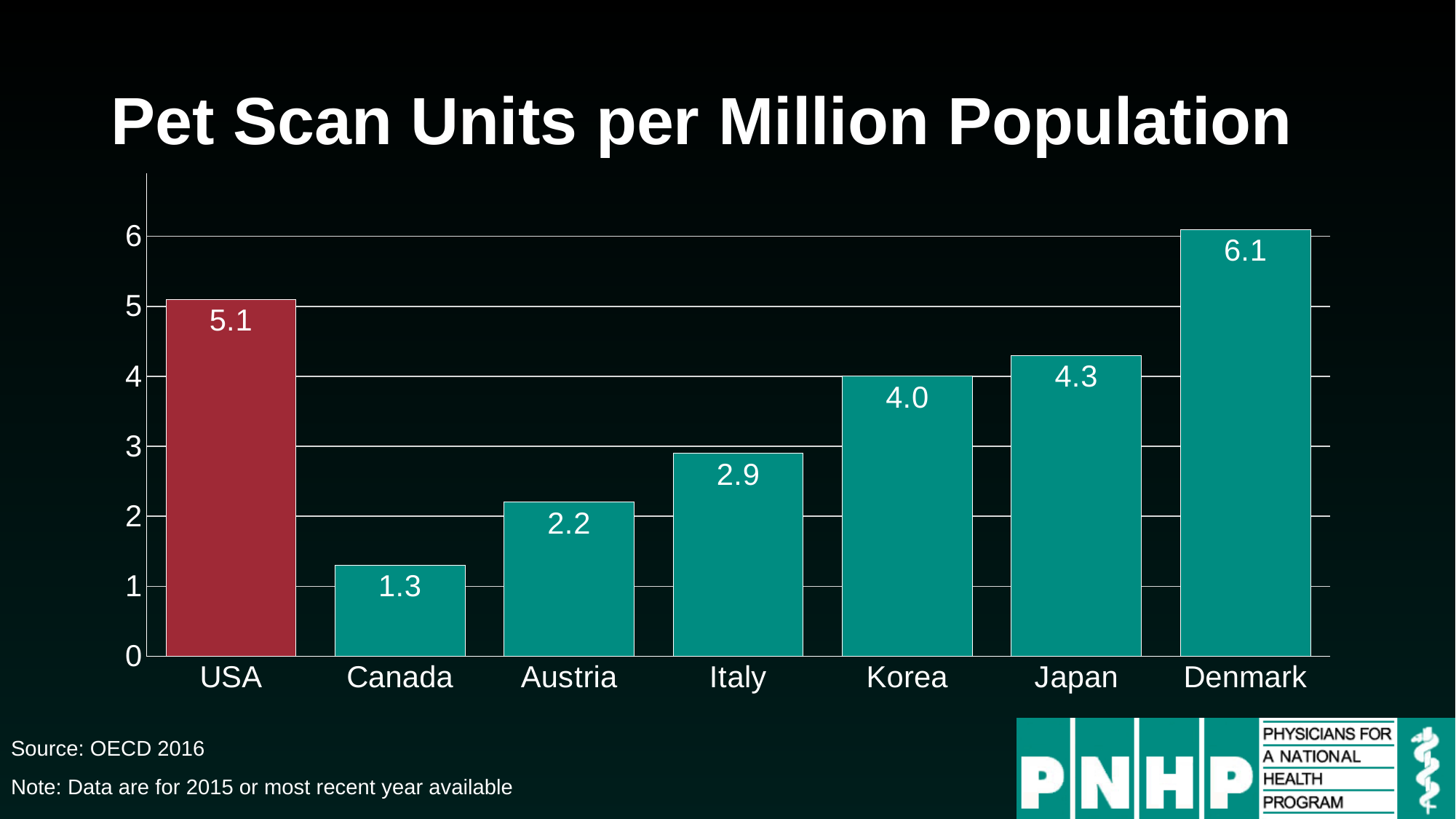
What is the value for the USA? 5.1 How many countries are shown in the chart? 7 Is the value for Austria greater or less than 3? less What is the value for Canada? 1.3 Which bar is coloured differently from the others? USA Which country has the highest value? Denmark What is the value for Japan? 4.3 What is the difference between the values for Denmark and the USA? 1.0 Which country has the lowest value? Canada What kind of chart is shown on the slide? bar chart Which is larger, the value for Korea or the value for Italy? Korea What is the difference between the values for Italy and Austria? 0.7